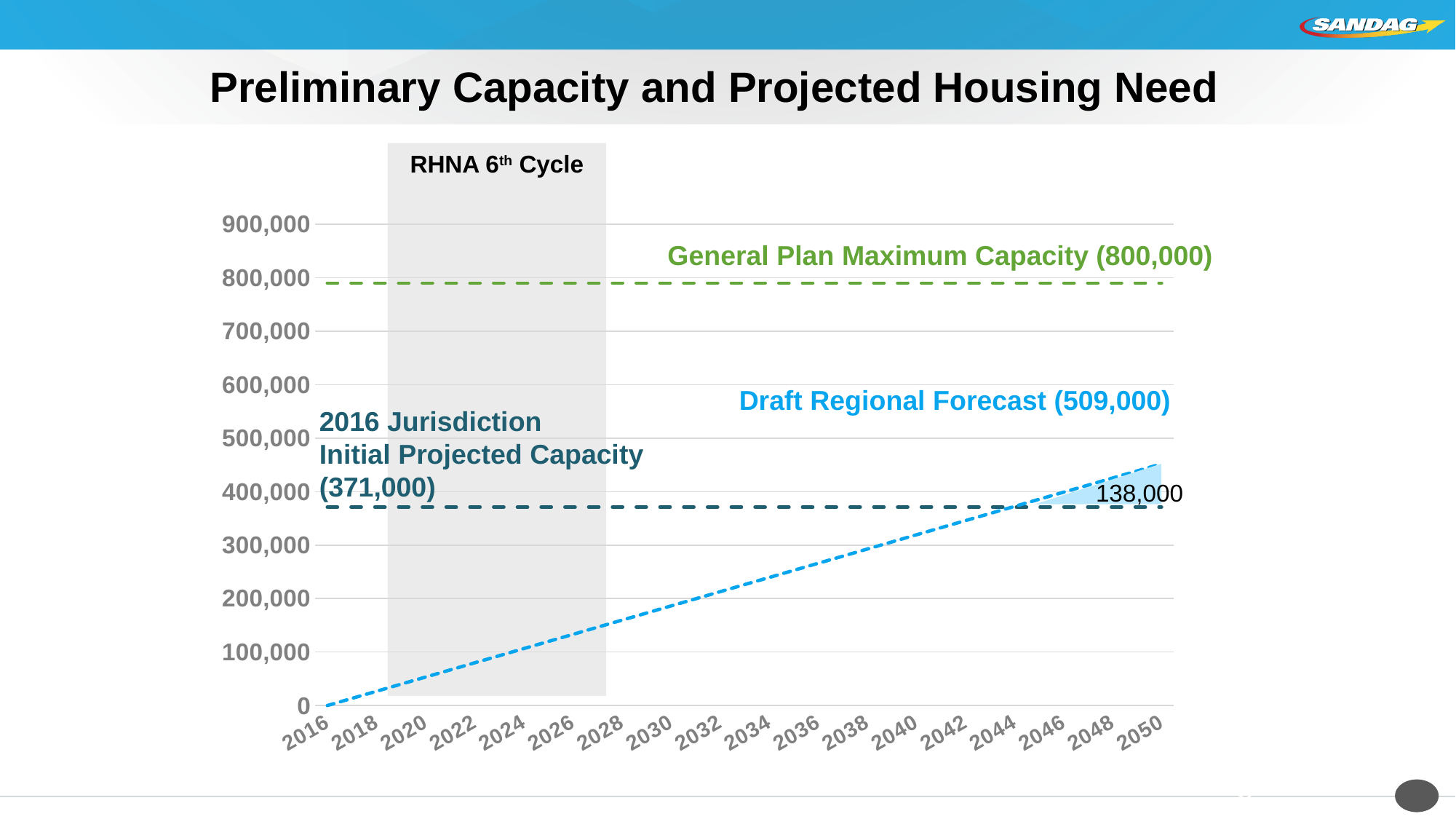
Which is larger, the General Plan Maximum Capacity or the Draft Regional Forecast? General Plan Maximum Capacity What value is given for the Draft Regional Forecast? 509,000 How many year labels are shown on the x axis? 18 Which of the three labeled lines has the lowest value? 2016 Jurisdiction Initial Projected Capacity What kind of chart is shown on the slide? line chart What value is given for the General Plan Maximum Capacity? 800,000 What is the difference between the Draft Regional Forecast and the 2016 Jurisdiction Initial Projected Capacity? 138,000 Is the Draft Regional Forecast line in 2030 greater or less than 300,000? less What label is shown on the shaded vertical band in the chart? RHNA 6th Cycle What value is given for the 2016 Jurisdiction Initial Projected Capacity? 371,000 Does the Draft Regional Forecast line rise or fall from 2016 to 2050? rises Which of the three labeled lines has the highest value? General Plan Maximum Capacity